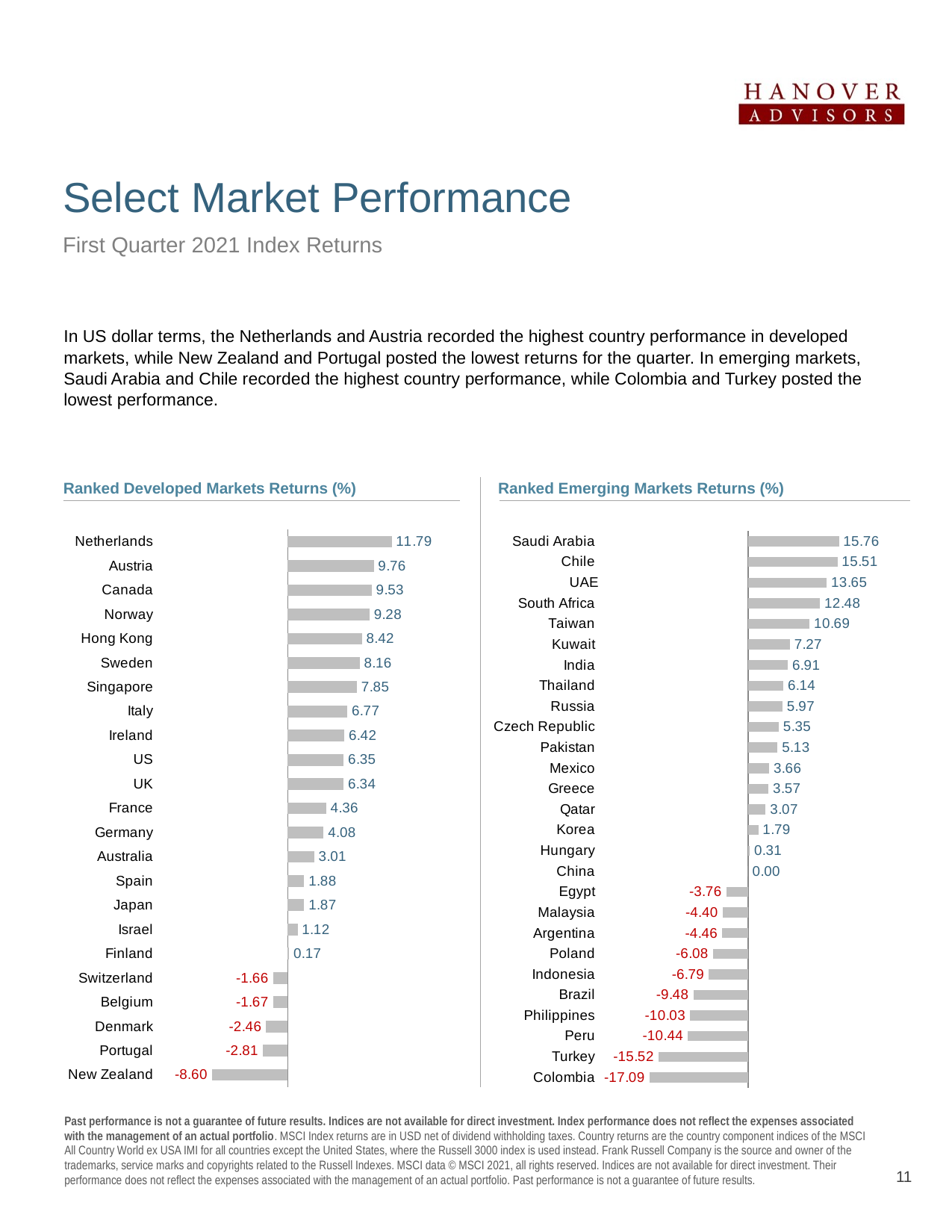
In the Ranked Emerging Markets Returns (%) chart, what is the value for Turkey? -15.52 In the Ranked Developed Markets Returns (%) chart, which country has the lowest return? New Zealand In the Ranked Developed Markets Returns (%) chart, what is the value for Canada? 9.53 In the Ranked Emerging Markets Returns (%) chart, which country has the lowest return? Colombia How many countries are shown in the Ranked Developed Markets Returns (%) chart? 23 In the Ranked Developed Markets Returns (%) chart, what is the difference between the values for Netherlands and Austria? 2.03 In the Ranked Emerging Markets Returns (%) chart, what is the difference between the values for Taiwan and Kuwait? 3.42 What type of chart is the Ranked Emerging Markets Returns (%) chart? Bar chart How many countries are shown in the Ranked Emerging Markets Returns (%) chart? 27 In the Ranked Developed Markets Returns (%) chart, which country has the highest return? Netherlands In the Ranked Emerging Markets Returns (%) chart, which is larger, the value for Mexico or the value for Qatar? Mexico In the Ranked Emerging Markets Returns (%) chart, what is the value for Taiwan? 10.69